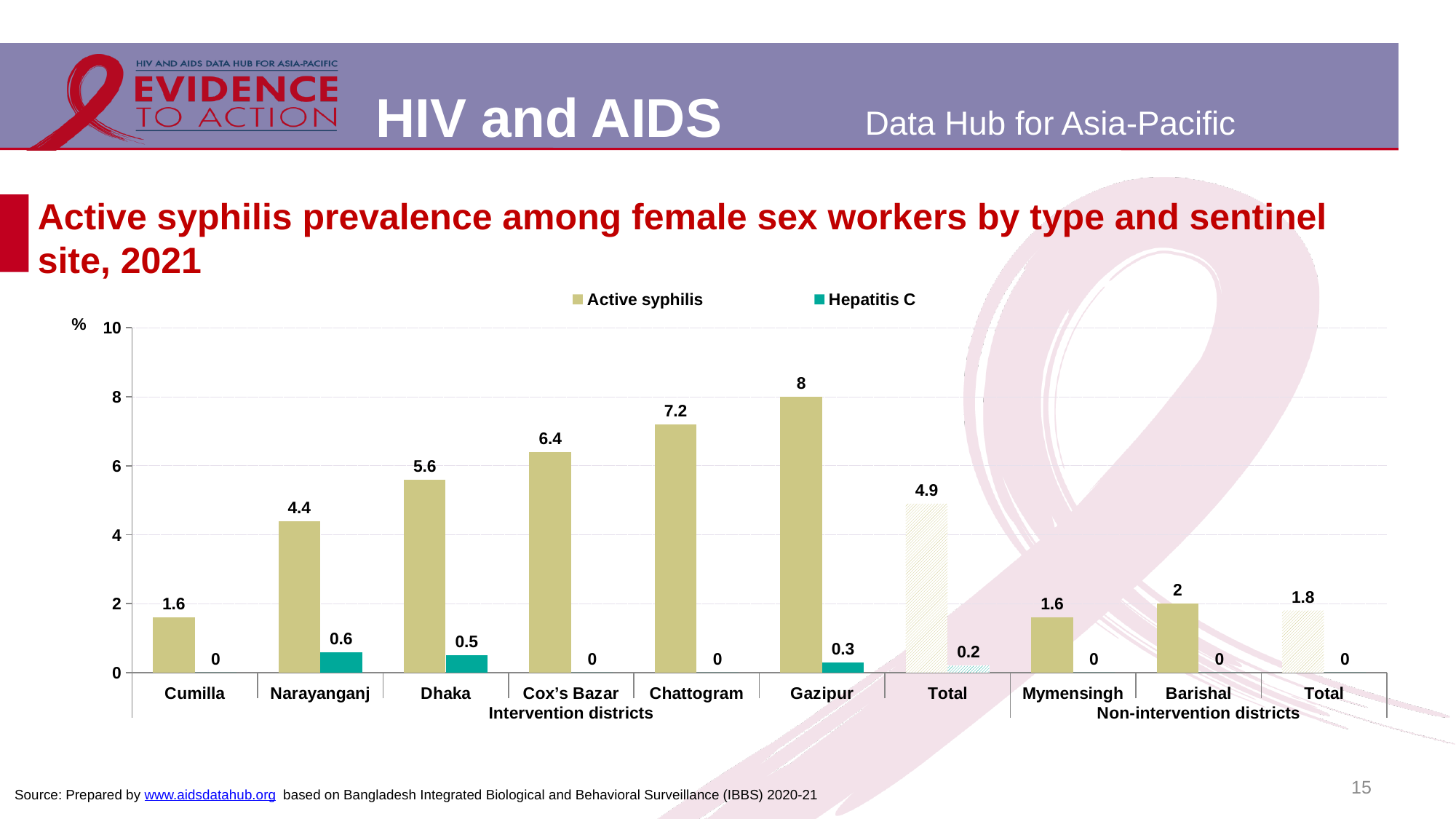
Is the Active syphilis value for Chattogram greater or less than 6? greater What is the Active syphilis value for the Total of the intervention districts? 4.9 What is the Active syphilis value for Barishal? 2 What is the difference between the Active syphilis values for Chattogram and Dhaka? 1.6 Which sentinel site has the highest Active syphilis value? Gazipur What kind of chart is shown on the slide? Bar chart What is the Active syphilis value for Gazipur? 8 What is the Hepatitis C value for Narayanganj? 0.6 What is the difference between the Active syphilis Total for intervention districts and the Total for non-intervention districts? 3.1 Which site has the highest Hepatitis C value? Narayanganj Which has a higher Active syphilis value, Cox's Bazar or Narayanganj? Cox's Bazar How many series does the legend list? 2